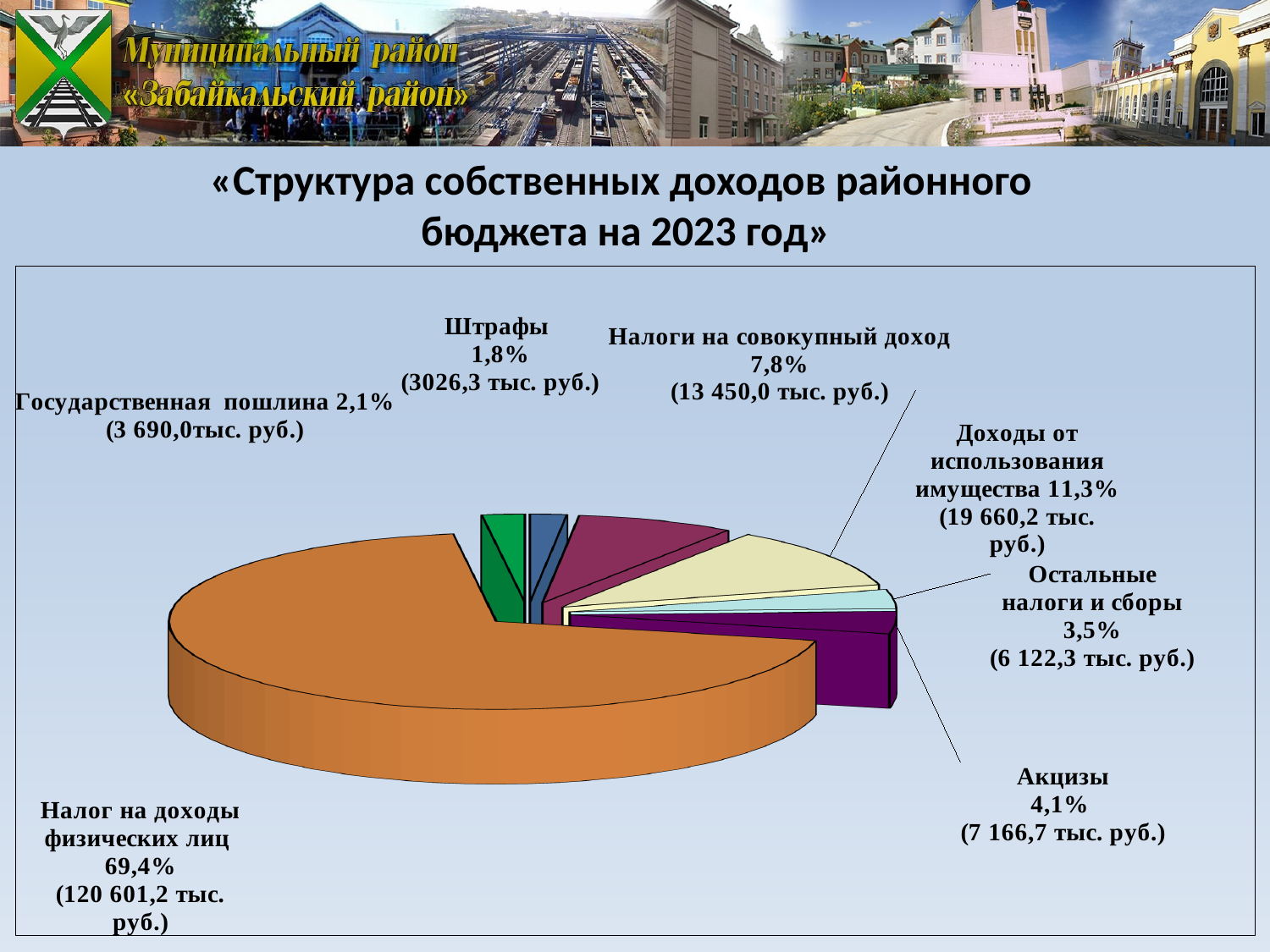
How many slices does the pie chart have? 7 Which category has the smallest share of the pie? Штрафы Which category has the largest share of the pie? Налог на доходы физических лиц What is the title of the chart on the slide? «Структура собственных доходов районного бюджета на 2023 год» What is the value in тыс. руб. for «Акцизы»? 7 166,7 тыс. руб. What is the value in тыс. руб. for «Доходы от использования имущества»? 19 660,2 тыс. руб. What is the value in тыс. руб. for «Государственная пошлина»? 3 690,0 тыс. руб. What share of the pie does «Налог на доходы физических лиц» have? 69,4% What kind of chart is shown on the slide? Pie chart What percentage share is shown for «Штрафы»? 1,8% Which is larger: the share for «Налоги на совокупный доход» or for «Остальные налоги и сборы»? Налоги на совокупный доход What is the difference in percentage points between «Доходы от использования имущества» (11,3%) and «Налоги на совокупный доход» (7,8%)? 3,5